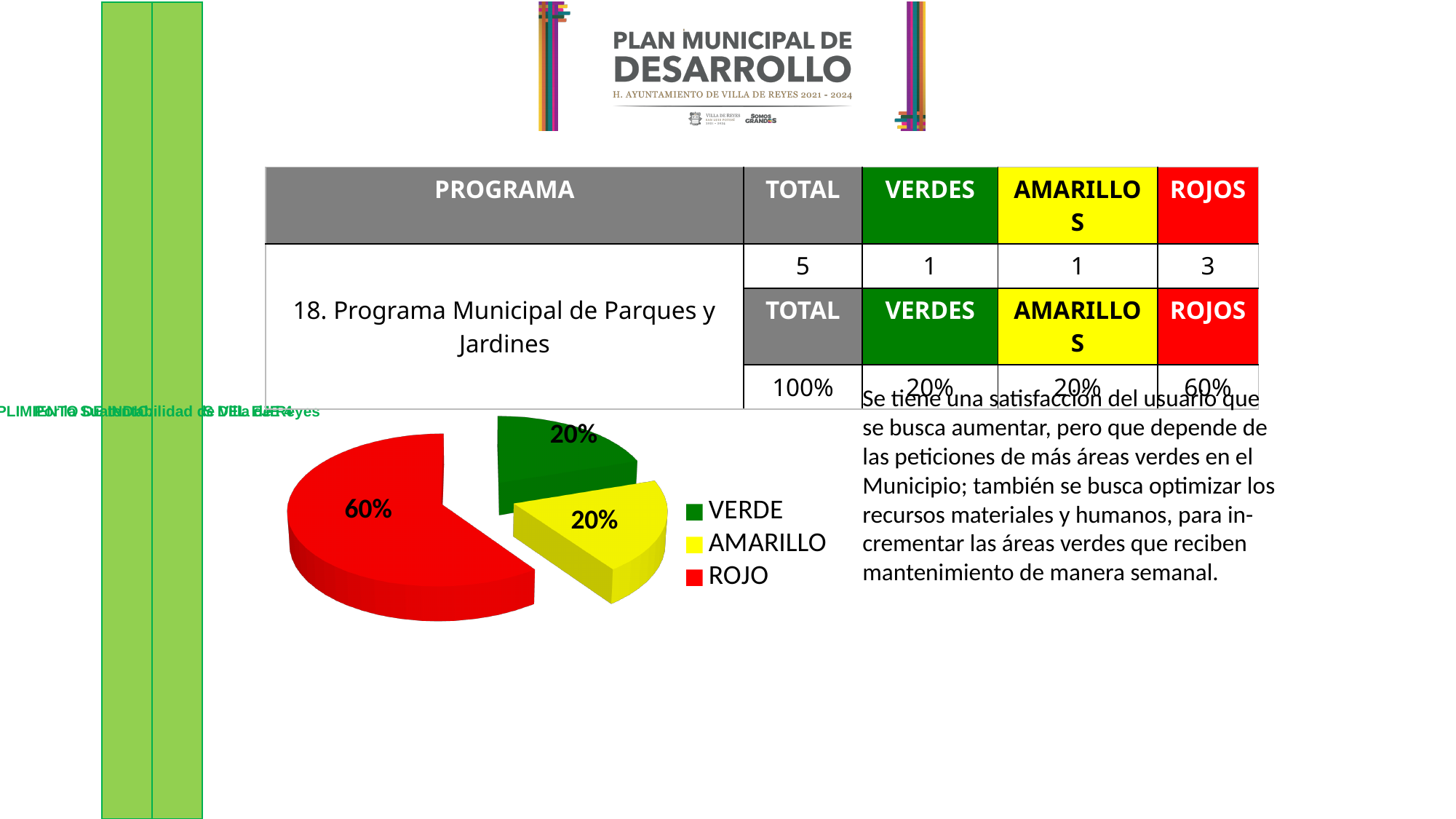
What is the combined share of the VERDE and AMARILLO slices in the pie chart? 40% What share of the pie does the VERDE slice represent? 20% What colour is the ROJO slice in the pie chart? red What kind of chart is shown on the slide? pie chart What share of the pie does the ROJO slice represent? 60% What colour is the AMARILLO slice in the pie chart? yellow What share of the pie does the AMARILLO slice represent? 20% Which slice of the pie chart is the largest? ROJO How many entries does the legend of the pie chart list? 3 How many slices does the pie chart have? 3 Which is larger in the pie chart, the ROJO slice or the AMARILLO slice? ROJO What is the difference between the ROJO share and the VERDE share in the pie chart? 40%